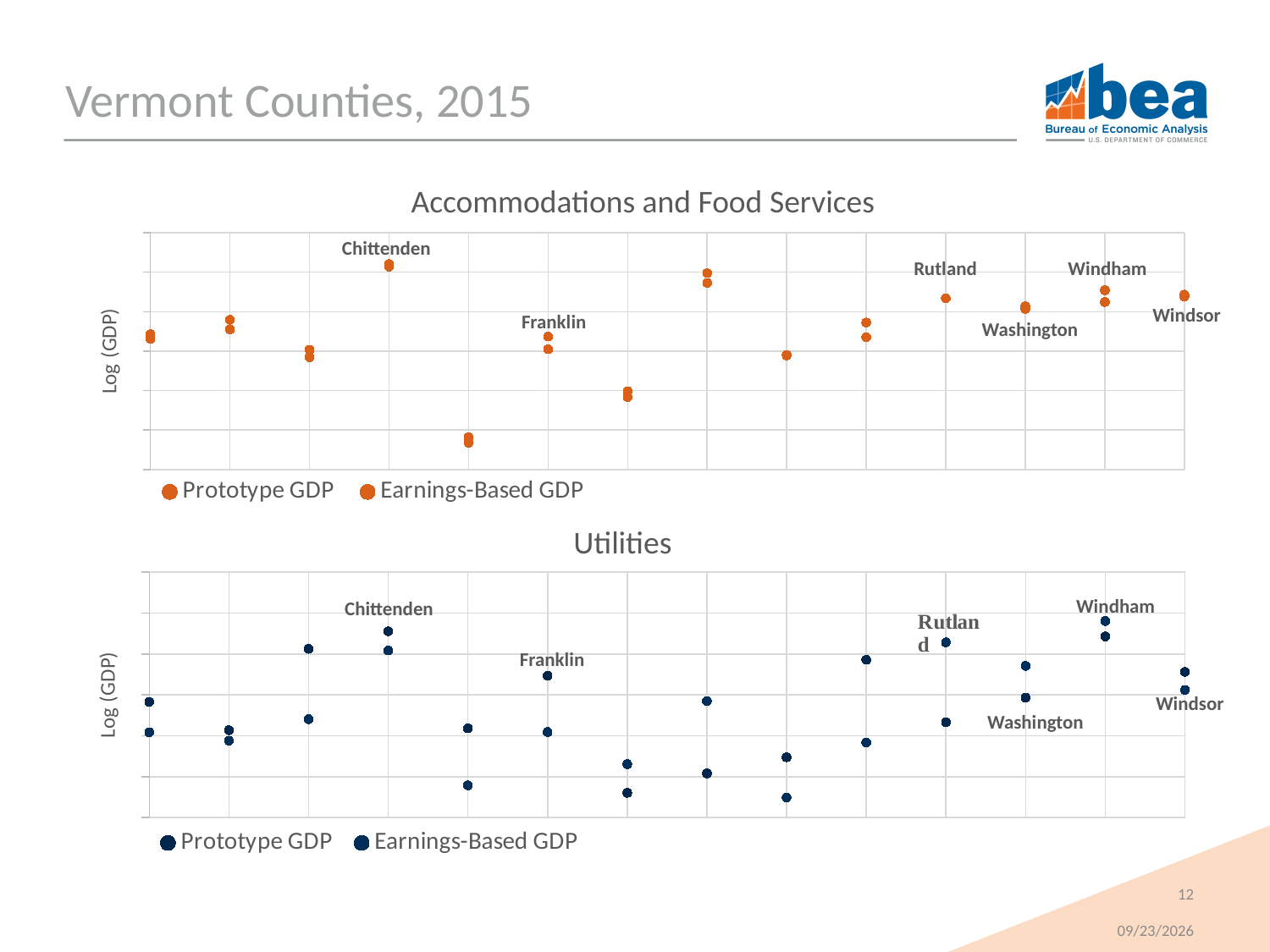
In the "Accommodations and Food Services" chart, which county has the higher Log (GDP): Chittenden or Franklin? Chittenden What kind of chart is the "Accommodations and Food Services" chart? scatter chart What are the two legend entries of the "Utilities" chart? Prototype GDP and Earnings-Based GDP What is the title of the top chart on the slide? Accommodations and Food Services How many counties are labelled by name on the "Utilities" chart? 6 In the "Utilities" chart, which county has the higher Log (GDP): Windham or Washington? Windham How many series does the legend of the "Utilities" chart list? 2 In the "Accommodations and Food Services" chart, which county has the higher Log (GDP): Rutland or Franklin? Rutland How many series does the legend of the "Accommodations and Food Services" chart list? 2 What kind of chart is the "Utilities" chart? scatter chart